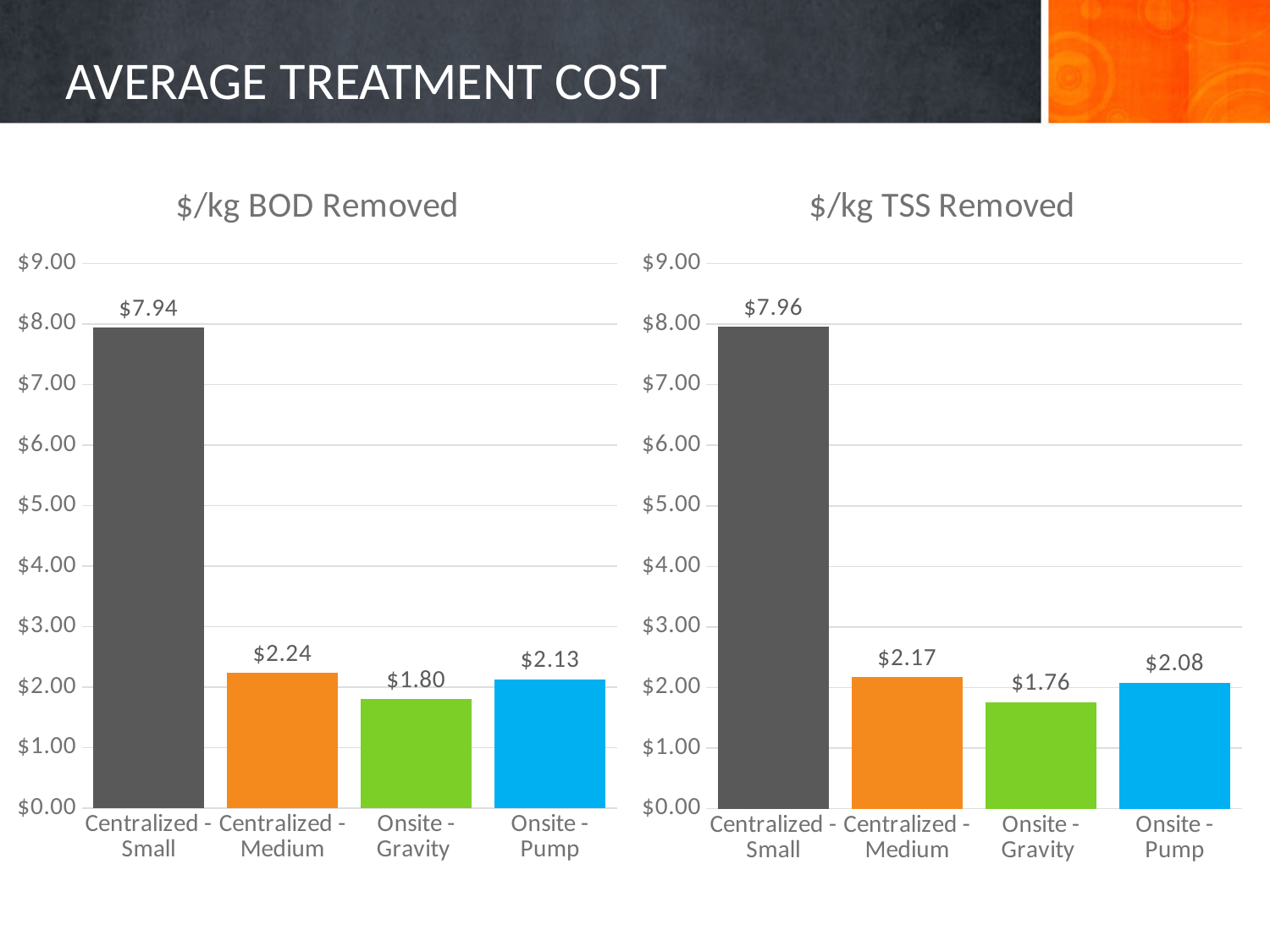
In the "$/kg TSS Removed" chart, which category has the lowest value? Onsite - Gravity In the "$/kg TSS Removed" chart, what is the value for Onsite - Gravity? $1.76 In the "$/kg TSS Removed" chart, is the value for Onsite - Pump greater or less than $3.00? less What is the title of the chart on the left side of the slide? $/kg BOD Removed How many categories are shown in the "$/kg BOD Removed" chart? 4 In the "$/kg BOD Removed" chart, what is the value for Centralized - Small? $7.94 In the "$/kg BOD Removed" chart, which is larger: Centralized - Medium or Onsite - Pump? Centralized - Medium In the "$/kg BOD Removed" chart, what is the difference between Centralized - Medium and Onsite - Gravity? $0.44 In the "$/kg TSS Removed" chart, what is the difference between Centralized - Small and Onsite - Pump? $5.88 In the "$/kg TSS Removed" chart, what is the value for Centralized - Medium? $2.17 What kind of chart is the "$/kg TSS Removed" chart? bar chart In the "$/kg BOD Removed" chart, which category has the highest value? Centralized - Small